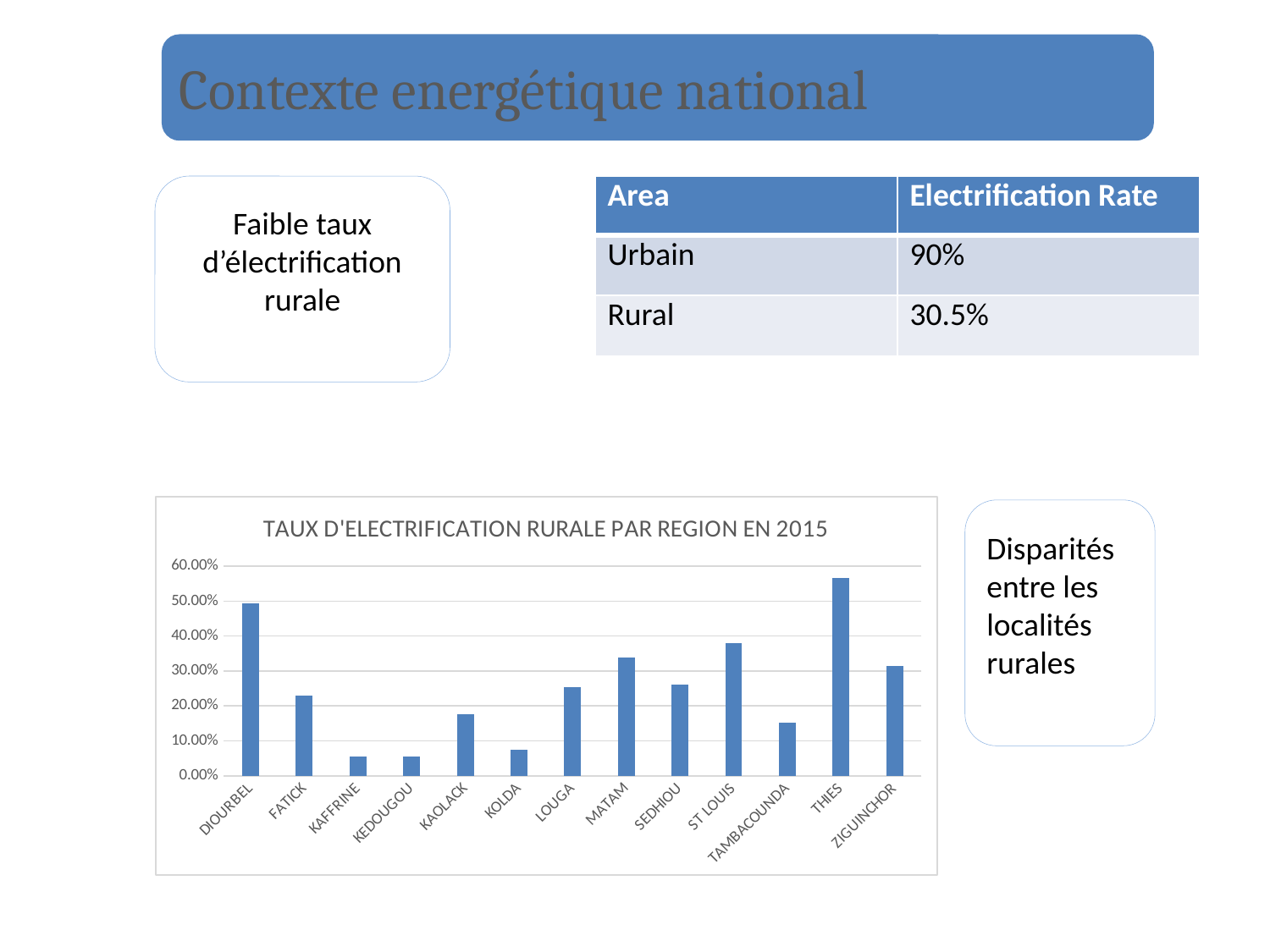
Is the value for DIOURBEL greater or less than 40.00%? greater Which has the larger value, KOLDA or ZIGUINCHOR? ZIGUINCHOR Is the value for TAMBACOUNDA greater or less than 20.00%? less Is the value for THIES greater or less than 50.00%? greater Which has the larger value, DIOURBEL or SEDHIOU? DIOURBEL How many regions are shown on the x axis of the chart? 13 Which has the larger value, MATAM or FATICK? MATAM What is the title of the chart? TAUX D'ELECTRIFICATION RURALE PAR REGION EN 2015 Which region has the highest rural electrification rate in the chart? THIES What kind of chart is shown on the slide? bar chart